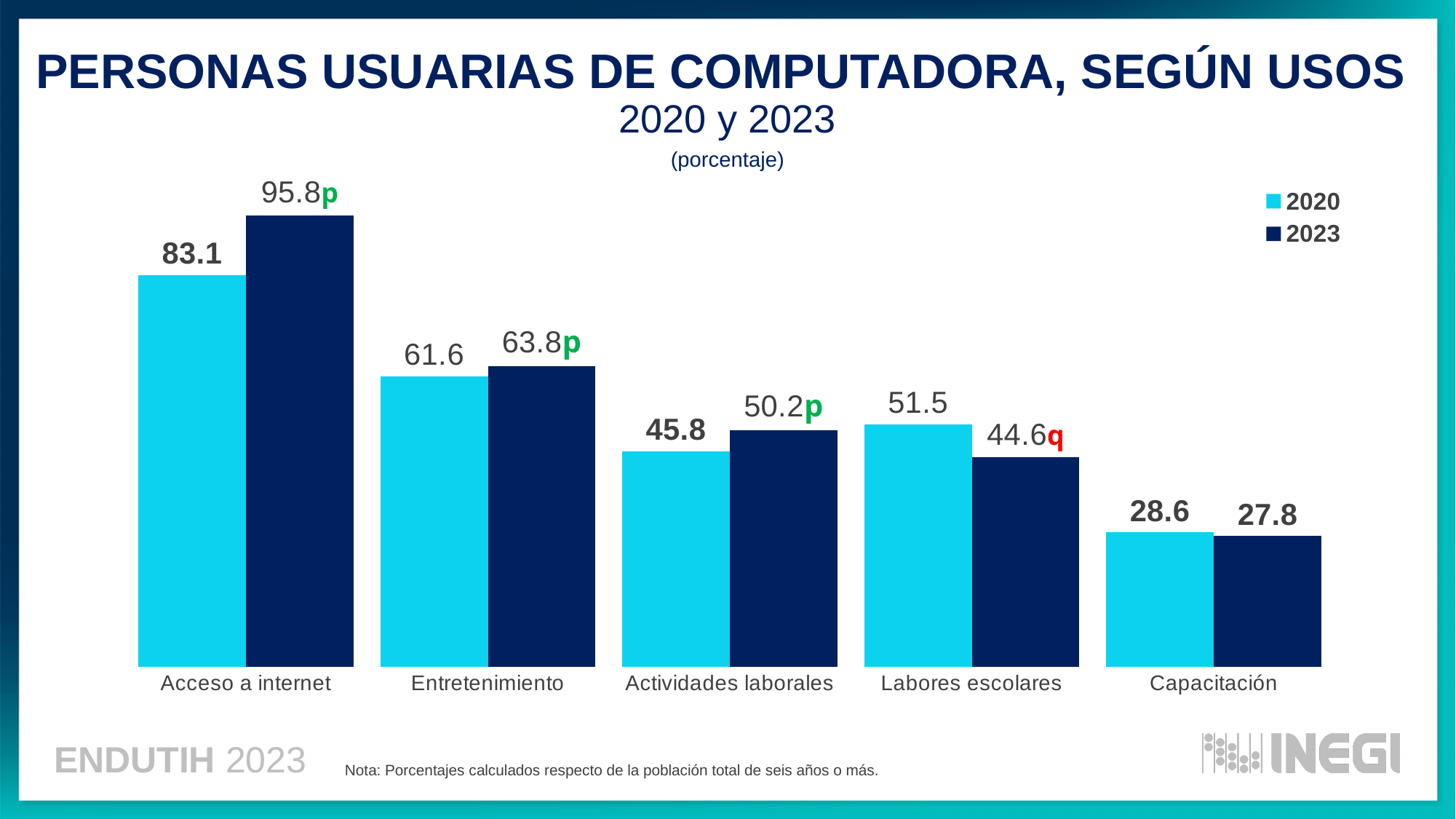
Which series is shown in dark navy blue according to the legend? 2023 How many series does the legend list? 2 What is the value for Capacitación in 2023? 27.8 Which category has the highest value in 2020? Acceso a internet What is the value for Acceso a internet in 2023? 95.8 Which category has the lowest value in 2023? Capacitación How many categories are shown on the x axis? 5 What is the difference between the 2020 and 2023 values for Labores escolares? 6.9 Which is larger for Actividades laborales, the 2020 value or the 2023 value? 2023 What is the difference between the 2023 and 2020 values for Acceso a internet? 12.7 What kind of chart is shown on the slide? Bar chart What is the value for Labores escolares in 2020? 51.5